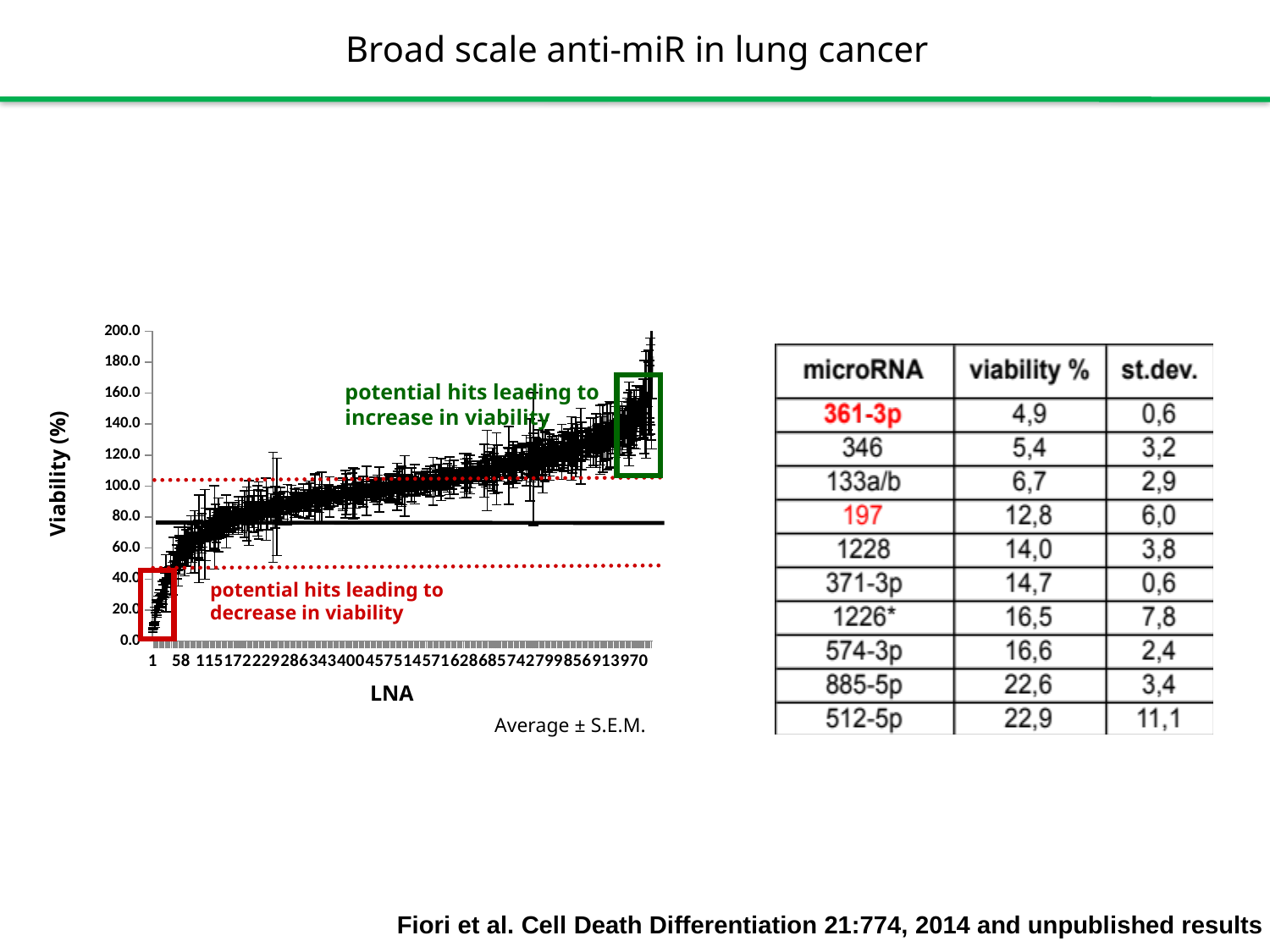
Is the viability value for the last LNA on the right of the chart greater or less than 140? greater Are the viability values of the LNAs in the red box greater or less than 60? less What is the label of the y axis of the chart? Viability (%) Are the viability values of the LNAs in the green box greater or less than 100? greater What kind of chart is shown on the left of the slide? scatter chart What is the label of the x axis of the chart? LNA Do the plotted viability values rise or fall from left to right along the LNA axis? rise